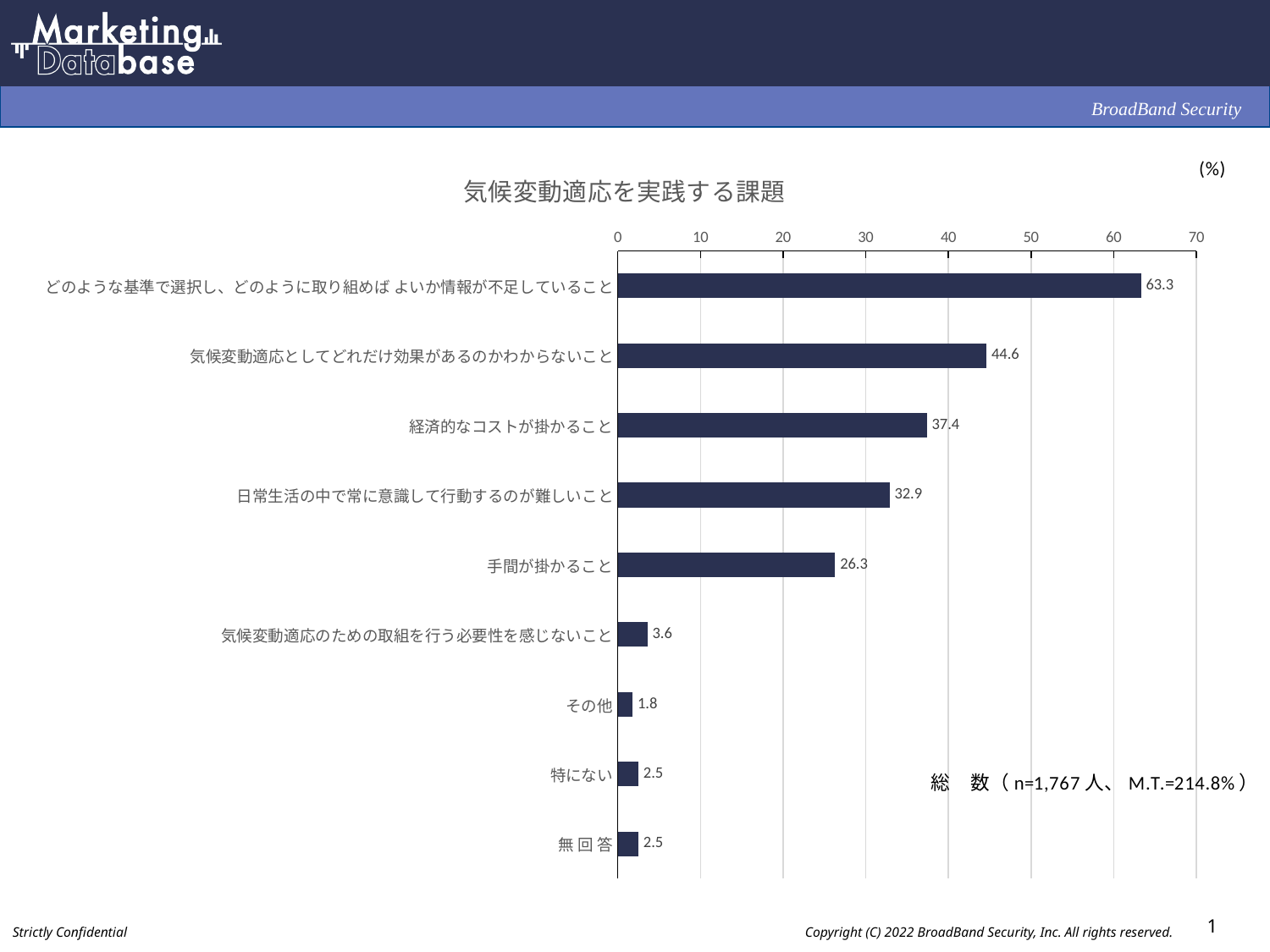
How many categories are shown in the chart? 9 What is the value for 経済的なコストが掛かること? 37.4 What is the value for 手間が掛かること? 26.3 What is the title of the chart? 気候変動適応を実践する課題 What is the difference between the values for 気候変動適応としてどれだけ効果があるのかわからないこと and 経済的なコストが掛かること? 7.2 What is the value for 気候変動適応のための取組を行う必要性を感じないこと? 3.6 Which is larger: the value for 日常生活の中で常に意識して行動するのが難しいこと or the value for 手間が掛かること? 日常生活の中で常に意識して行動するのが難しいこと Is the value for 気候変動適応としてどれだけ効果があるのかわからないこと greater or less than 40? greater What kind of chart is shown on the slide? bar chart Which category has the lowest value? その他 What is the sample size (n) shown on the slide? 1,767 Which category has the highest value? どのような基準で選択し、どのように取り組めばよいか情報が不足していること